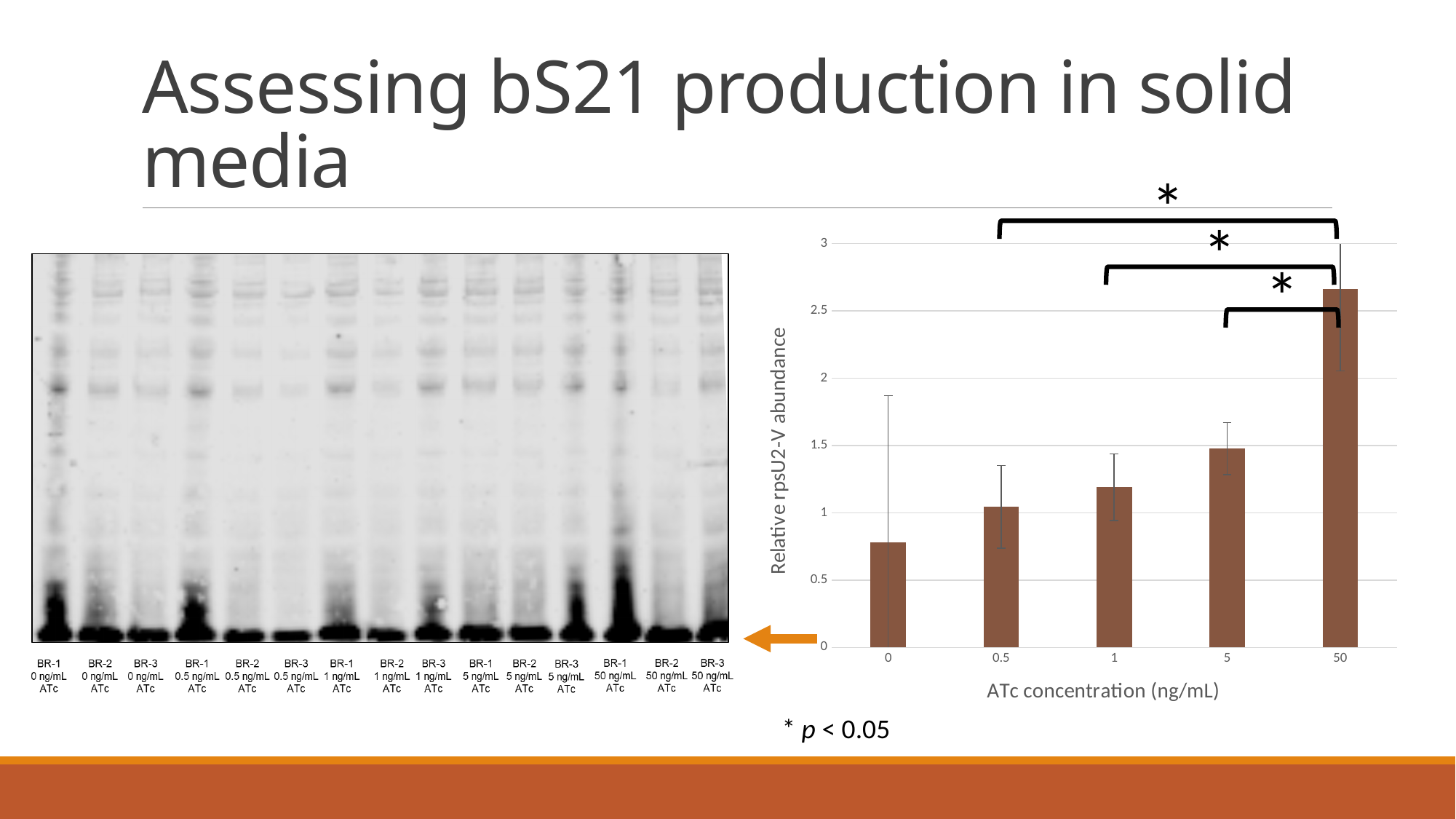
What kind of chart is shown on the right of the slide? bar chart Which ATc concentration has the lowest relative rpsU2-V abundance? 0 Is the relative rpsU2-V abundance at 5 ng/mL ATc greater or less than 1? greater How many ATc concentration categories are plotted in the bar chart? 5 Which has a larger relative rpsU2-V abundance, 5 ng/mL ATc or 50 ng/mL ATc? 50 ng/mL ATc Is the relative rpsU2-V abundance at 0 ng/mL ATc greater or less than 1? less Which ATc concentration has the highest relative rpsU2-V abundance? 50 Is the relative rpsU2-V abundance at 1 ng/mL ATc greater or less than 1.5? less What is the x-axis title of the bar chart? ATc concentration (ng/mL) Do the bar values rise or fall as ATc concentration increases along the x axis? rise What is the y-axis title of the bar chart? Relative rpsU2-V abundance